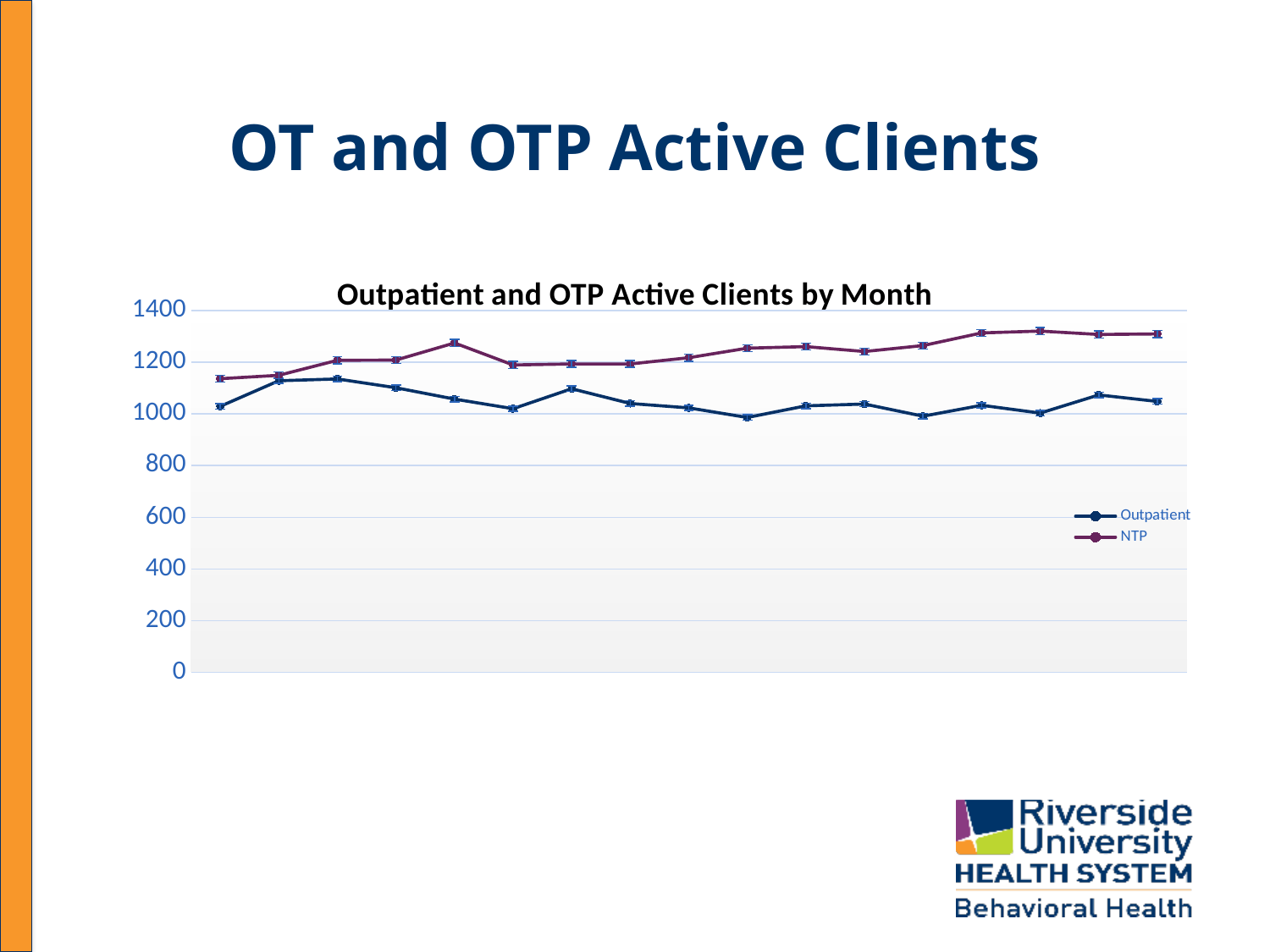
Which series has the higher values across the chart, Outpatient or NTP? NTP What are the two series named in the chart legend? Outpatient and NTP How many series does the chart legend list? 2 Is the value of the first Outpatient point greater or less than 1200? less Is the lowest Outpatient value greater or less than 800? greater Does the NTP series generally rise or fall from the first point to the last point? rise Is the highest NTP value greater or less than 1400? less What is the title of the chart? Outpatient and OTP Active Clients by Month Which series reaches the highest value on the chart? NTP What kind of chart is shown on the slide? line chart How many data points are plotted for the Outpatient series? 17